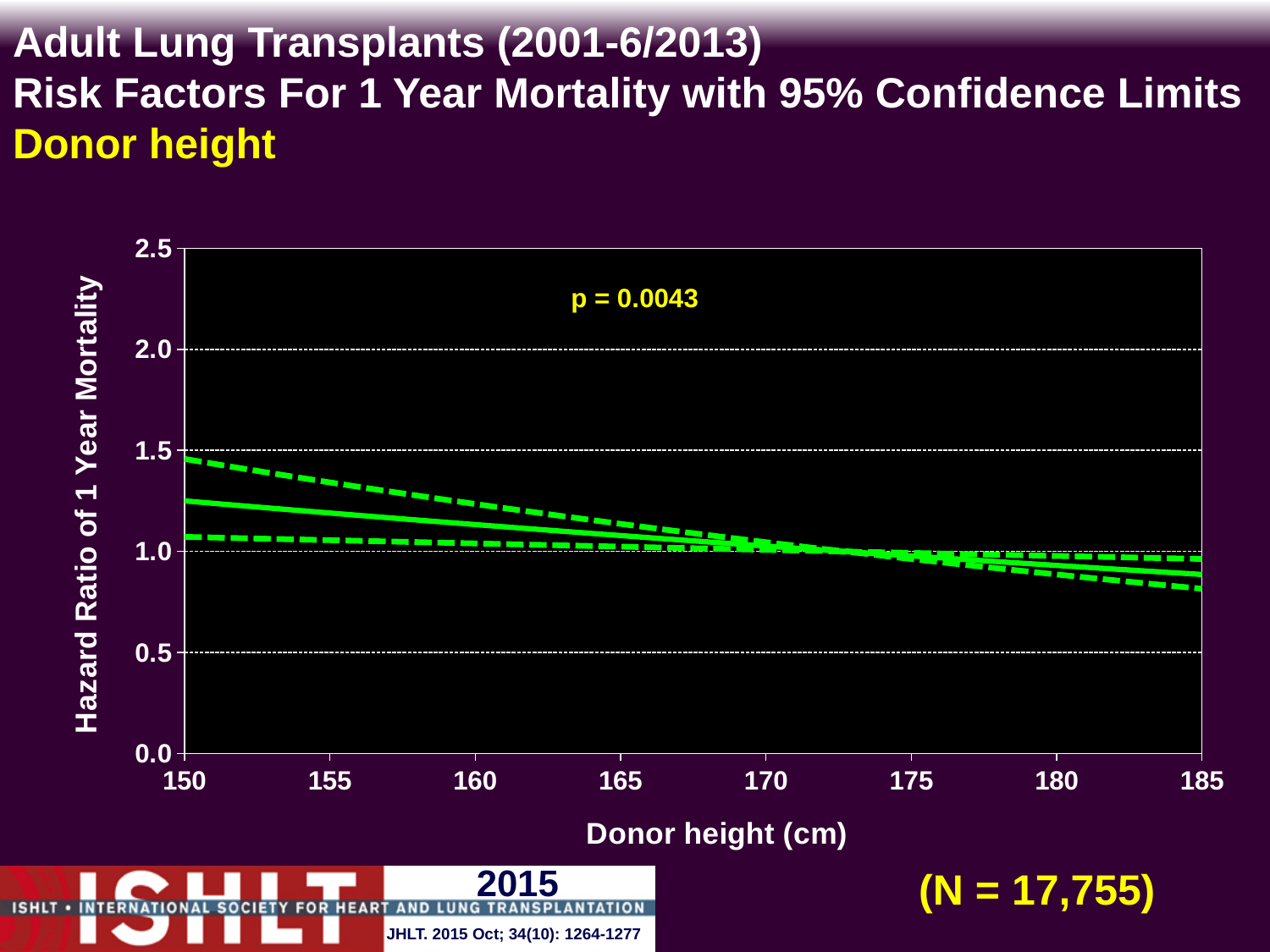
Does the hazard ratio of 1 year mortality rise or fall as donor height increases from 150 cm to 185 cm? fall What is the label of the x axis? Donor height (cm) Is the hazard ratio (solid line) at a donor height of 150 cm greater or less than 1.0? greater How many lines are plotted on the chart? 3 What is the label of the y axis? Hazard Ratio of 1 Year Mortality What is the p-value printed on the chart? p = 0.0043 Which donor height has the larger hazard ratio on the solid line, 150 cm or 185 cm? 150 cm Is the hazard ratio (solid line) at a donor height of 150 cm greater or less than 1.5? less What kind of chart is shown on the slide? line chart How many tick labels are shown on the x axis? 8 Is the hazard ratio (solid line) at a donor height of 185 cm greater or less than 0.5? greater